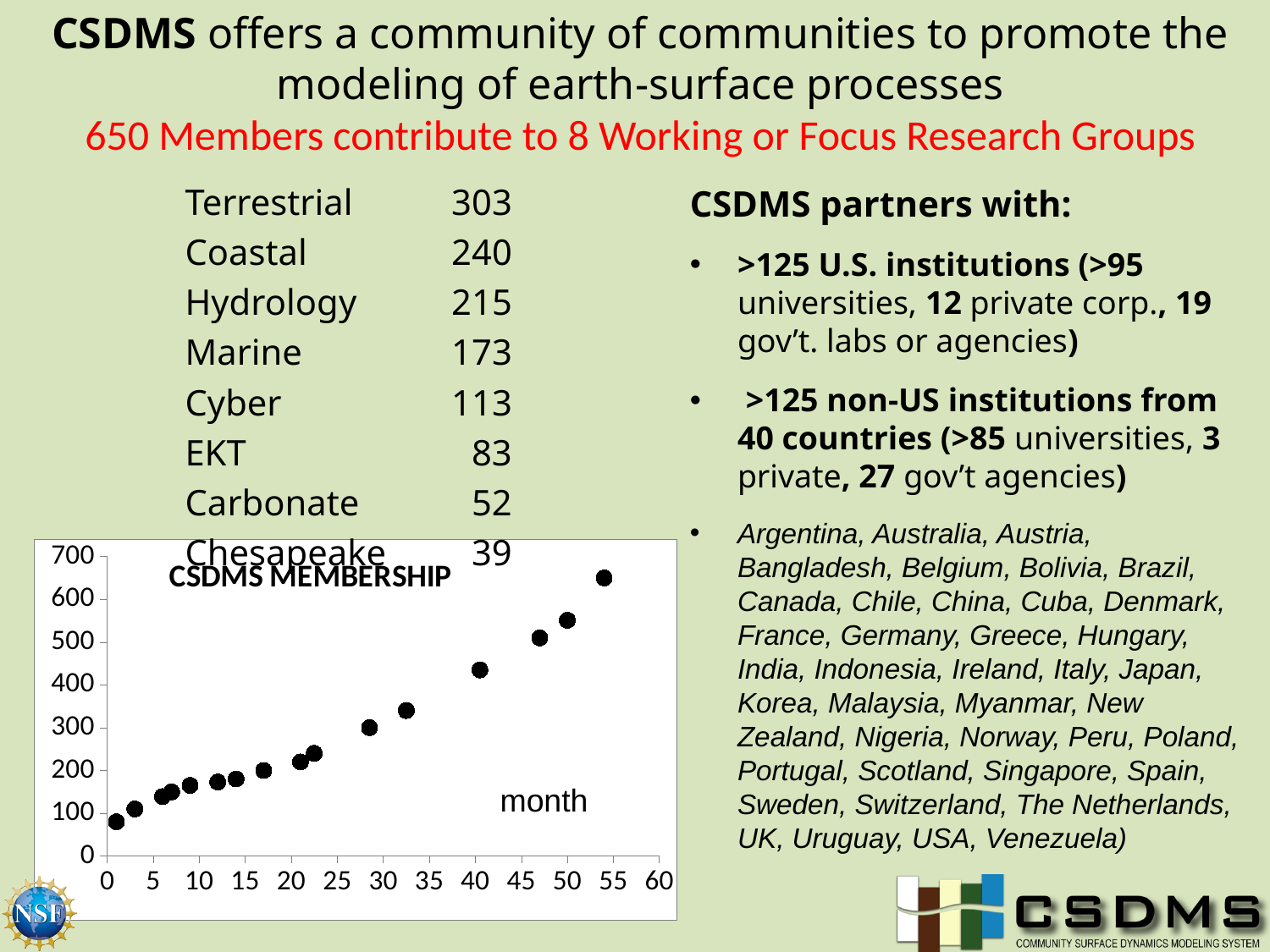
What is the highest value shown on the y axis of the CSDMS MEMBERSHIP chart? 700 What kind of chart is the CSDMS MEMBERSHIP chart? scatter chart In the CSDMS MEMBERSHIP chart, is the value at month 32 greater or less than 400? less In the CSDMS MEMBERSHIP chart, is the value of the first point (near month 1) greater or less than 100? less In the CSDMS MEMBERSHIP chart, is the value of the last point (near month 54) greater or less than 600? greater What is the title of the chart on the slide? CSDMS MEMBERSHIP In the CSDMS MEMBERSHIP chart, which point has the larger value: the one at month 40 or the one at month 50? month 50 Do the values in the CSDMS MEMBERSHIP chart rise or fall as the month increases? rise What is the label on the x axis of the CSDMS MEMBERSHIP chart? month